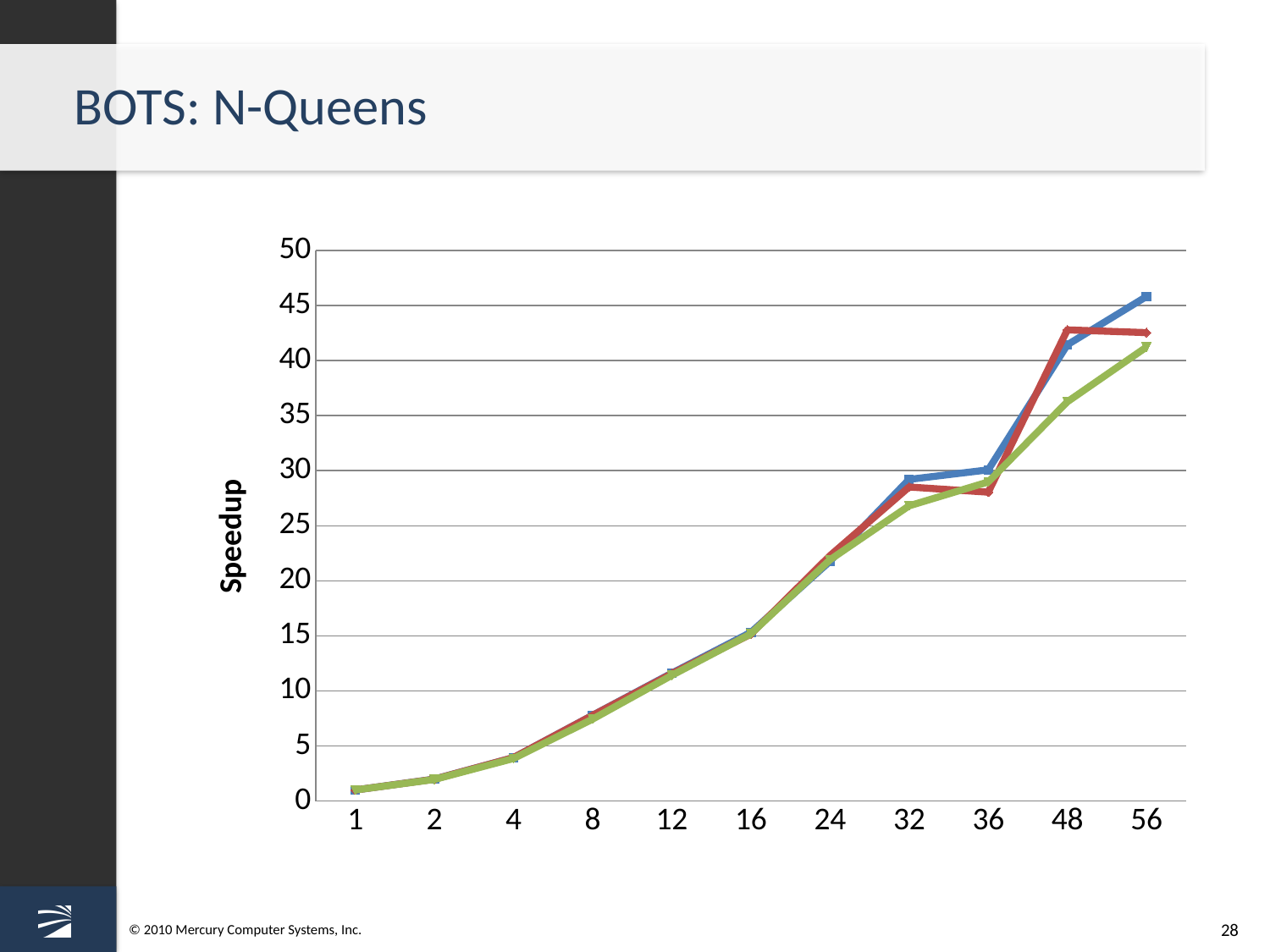
At x = 48, which line has the higher speedup, the red line or the green line? red line What is the title of the slide containing the chart? BOTS: N-Queens How many lines are plotted on the chart? 3 At x = 8, is the speedup of the blue line greater or less than 10? less At x = 48, is the speedup of the green line greater or less than 35? greater What kind of chart is shown on the slide? line chart At x = 56, which line has the higher speedup, the blue line or the green line? blue line At x = 36, is the speedup of the red line greater or less than 30? less How many points are marked along the x axis of the chart? 11 What is the label on the vertical axis of the chart? Speedup Do the speedup values generally rise or fall as the x-axis value increases from 1 to 56? rise